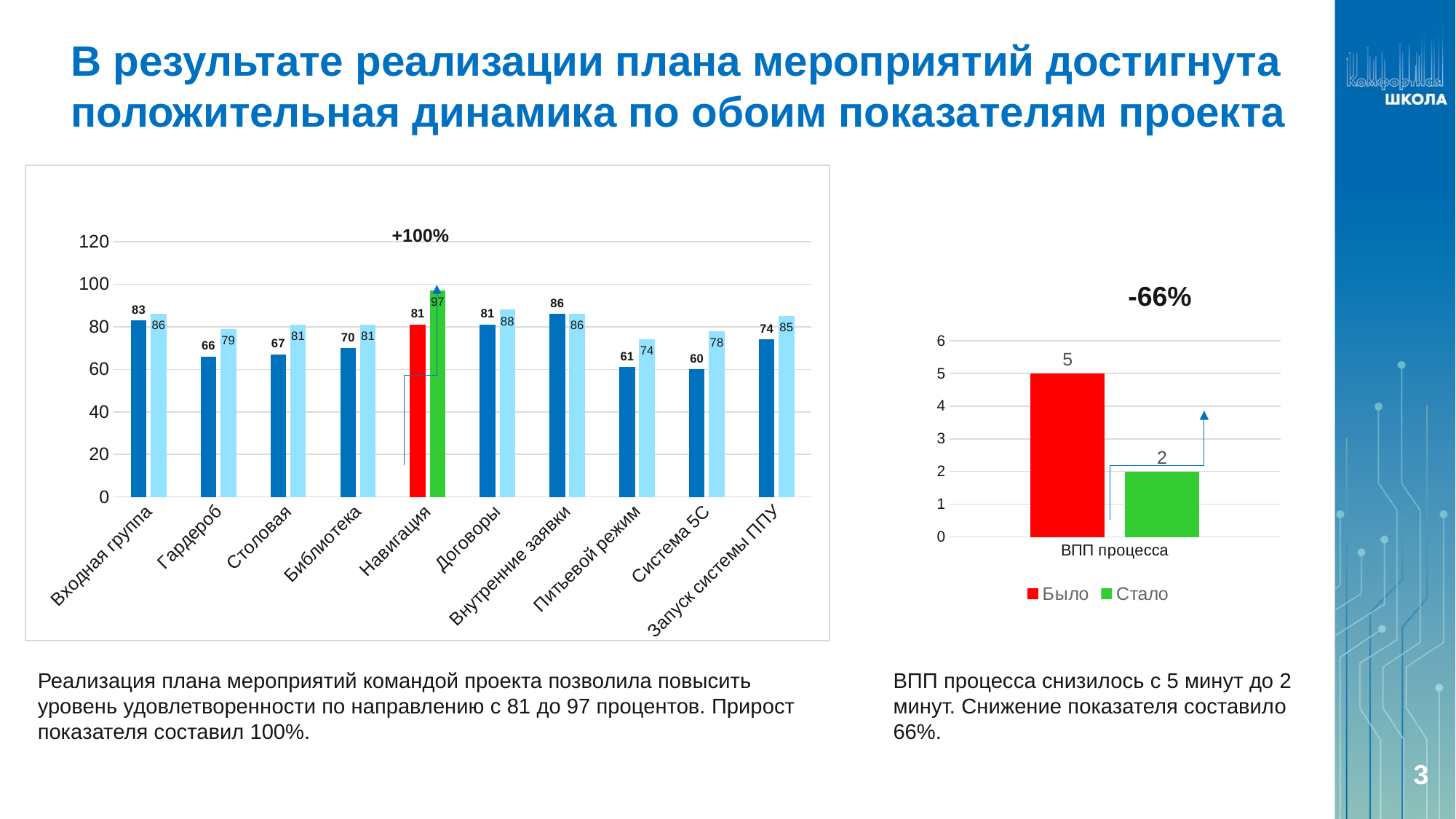
On the left chart, what is the value of the first (dark blue) bar for Система 5С? 60 On the left chart, what is the value of the second (light blue) bar for Навигация? 97 On the chart titled -66%, what is the value for Было? 5 On the chart titled -66%, how many series does the legend list? 2 On the left chart, which category has the highest value for the second (light blue) bar? Навигация On the left chart, what is the difference between the second and first bars for Столовая? 14 On the left chart, is the first (dark blue) bar for Гардероб greater or less than 80? less On the left chart, what is the value of the first (dark blue) bar for Навигация? 81 On the left chart, which category has the lowest value for the first (dark blue) bar? Система 5С What kind of chart is the chart titled -66%? bar chart On the left chart, how many categories are shown on the x axis? 10 On the chart titled -66%, what is the difference between Было and Стало? 3